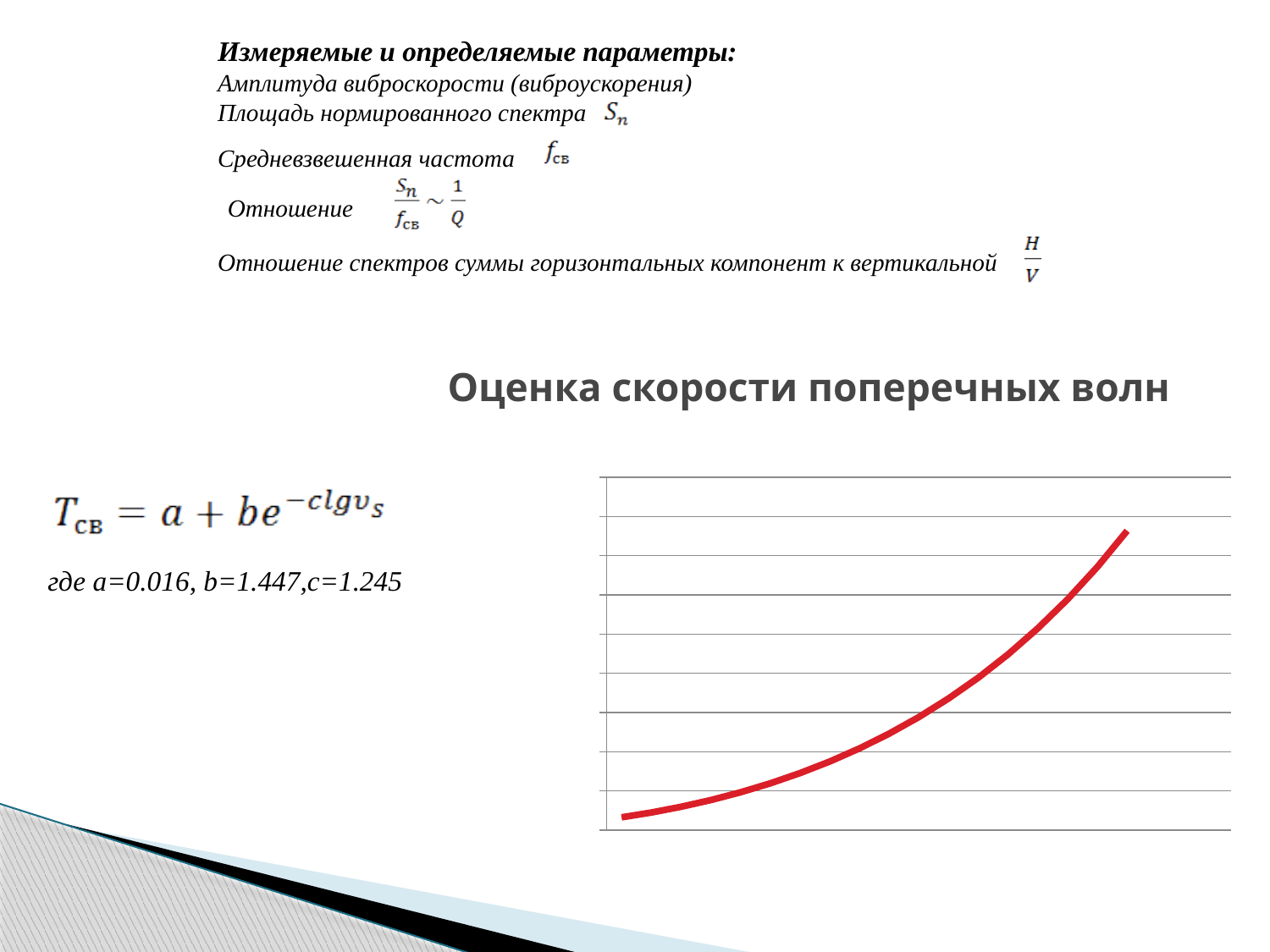
What colour is the plotted line on the chart? red Does the plotted line rise or fall from left to right? rises Is the plotted line straight or curved? curved How many lines are plotted on the chart? 1 What kind of chart is shown on the slide? line chart